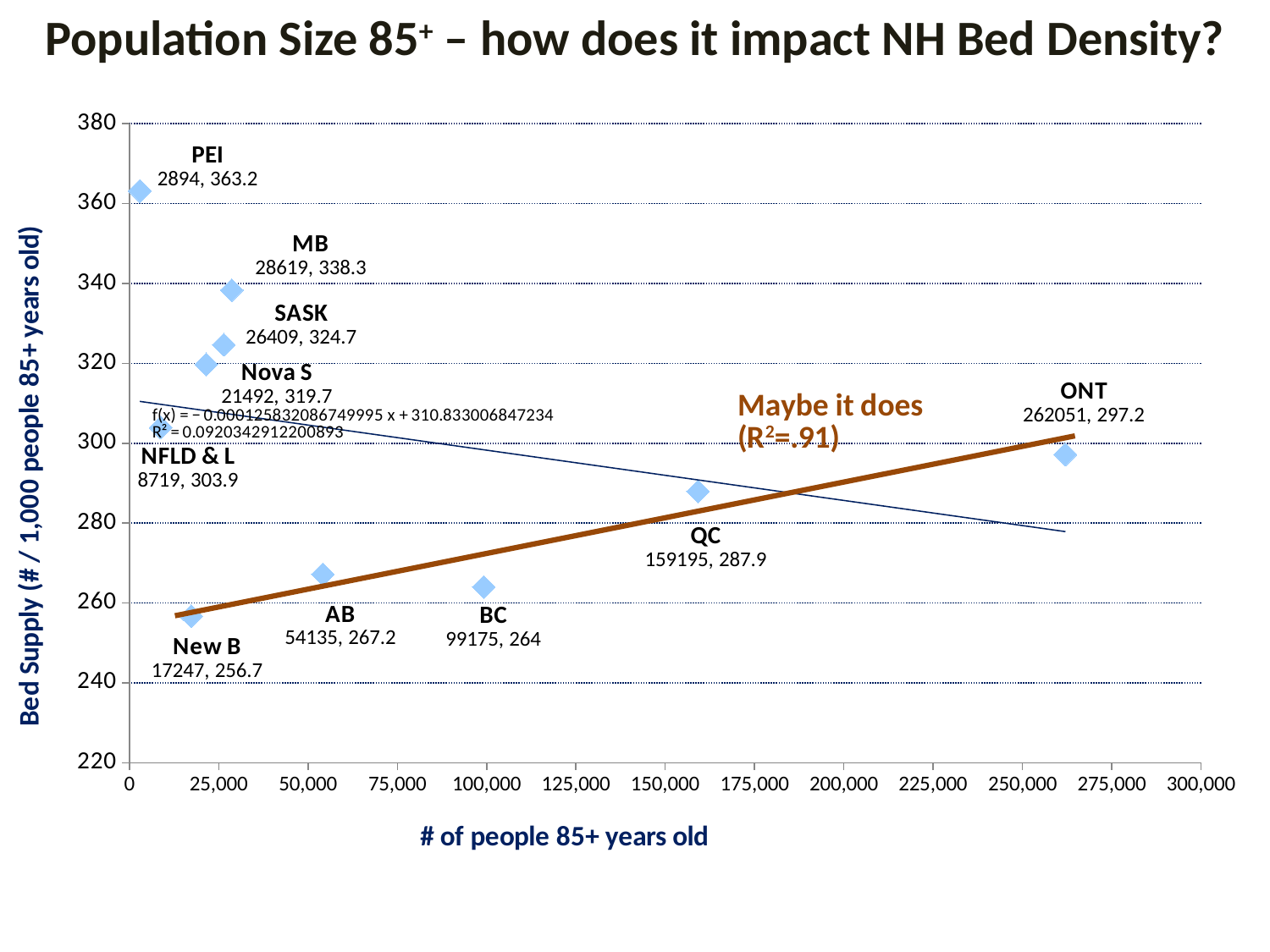
What is the bed supply value for QC? 287.9 Is the bed supply value for NFLD & L greater or less than 300? greater Which has a higher bed supply, AB or BC? AB What is the bed supply value for PEI? 363.2 What is the number of people 85+ years old for ONT? 262051 What R-squared value is given in the orange annotation on the chart? .91 How many provinces are plotted on the chart? 10 What is the label of the x axis? # of people 85+ years old What is the difference in bed supply between MB and SASK? 13.6 Which province has the highest bed supply? PEI Which province has the lowest bed supply? New B What type of chart is shown on the slide? Scatter chart